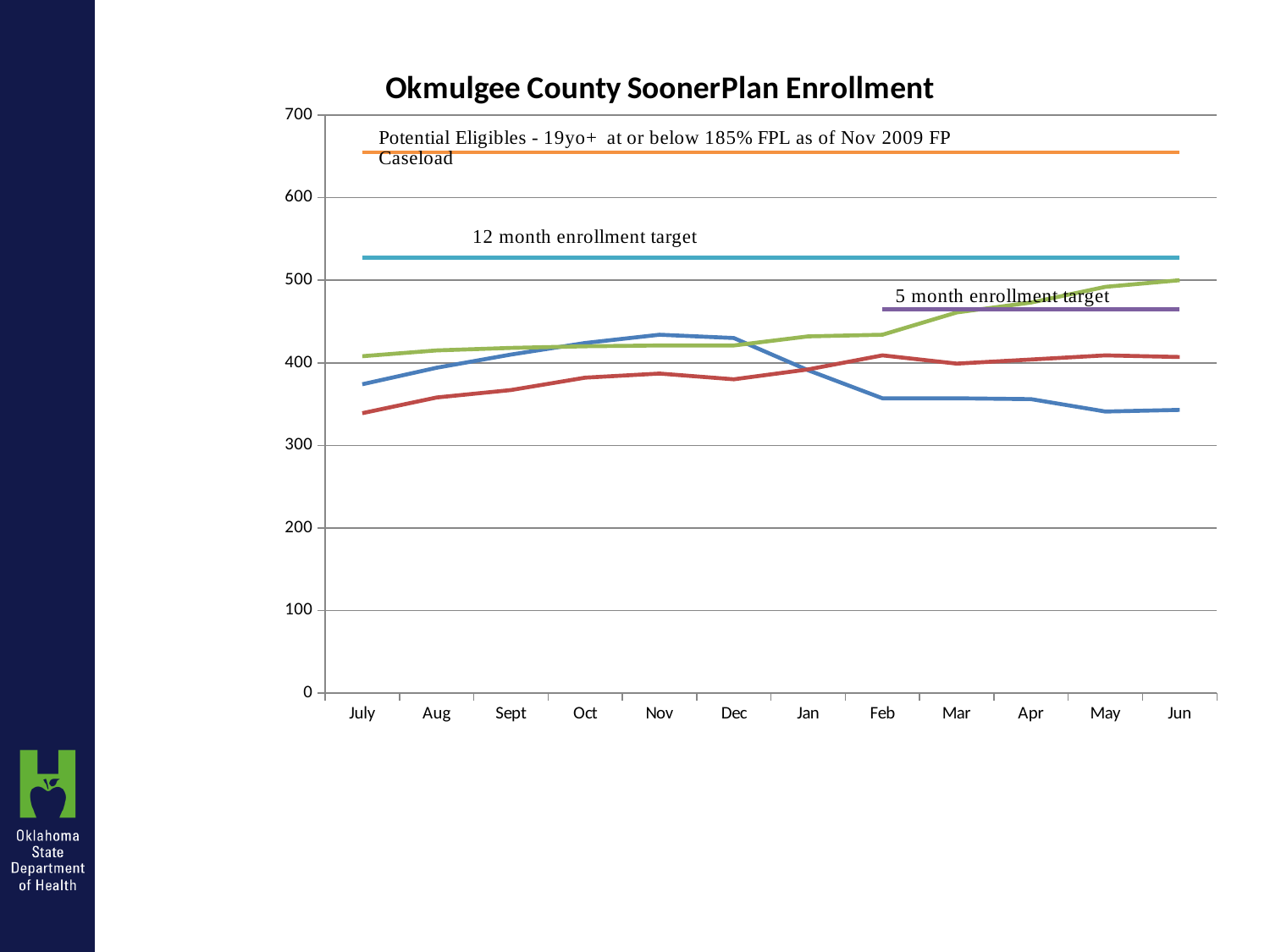
Over which months does the '5 month enrollment target' line extend? Feb to Jun Is the value of the 'Potential Eligibles - 19yo+ at or below 185% FPL as of Nov 2009 FP' line greater or less than 600? greater Is the value of the '5 month enrollment target' line greater or less than 400? greater Is the value of the '5 month enrollment target' line greater or less than 500? less What kind of chart is shown on the slide? line chart How many months are shown along the x axis of the chart? 12 What is the title of the chart? Okmulgee County SoonerPlan Enrollment Which is higher, the 'Potential Eligibles' line or the '12 month enrollment target' line? Potential Eligibles What is the highest value shown on the y axis of the chart? 700 Does the '12 month enrollment target' line rise, fall, or stay flat from July to Jun? stays flat Which is higher, the '12 month enrollment target' line or the '5 month enrollment target' line? 12 month enrollment target